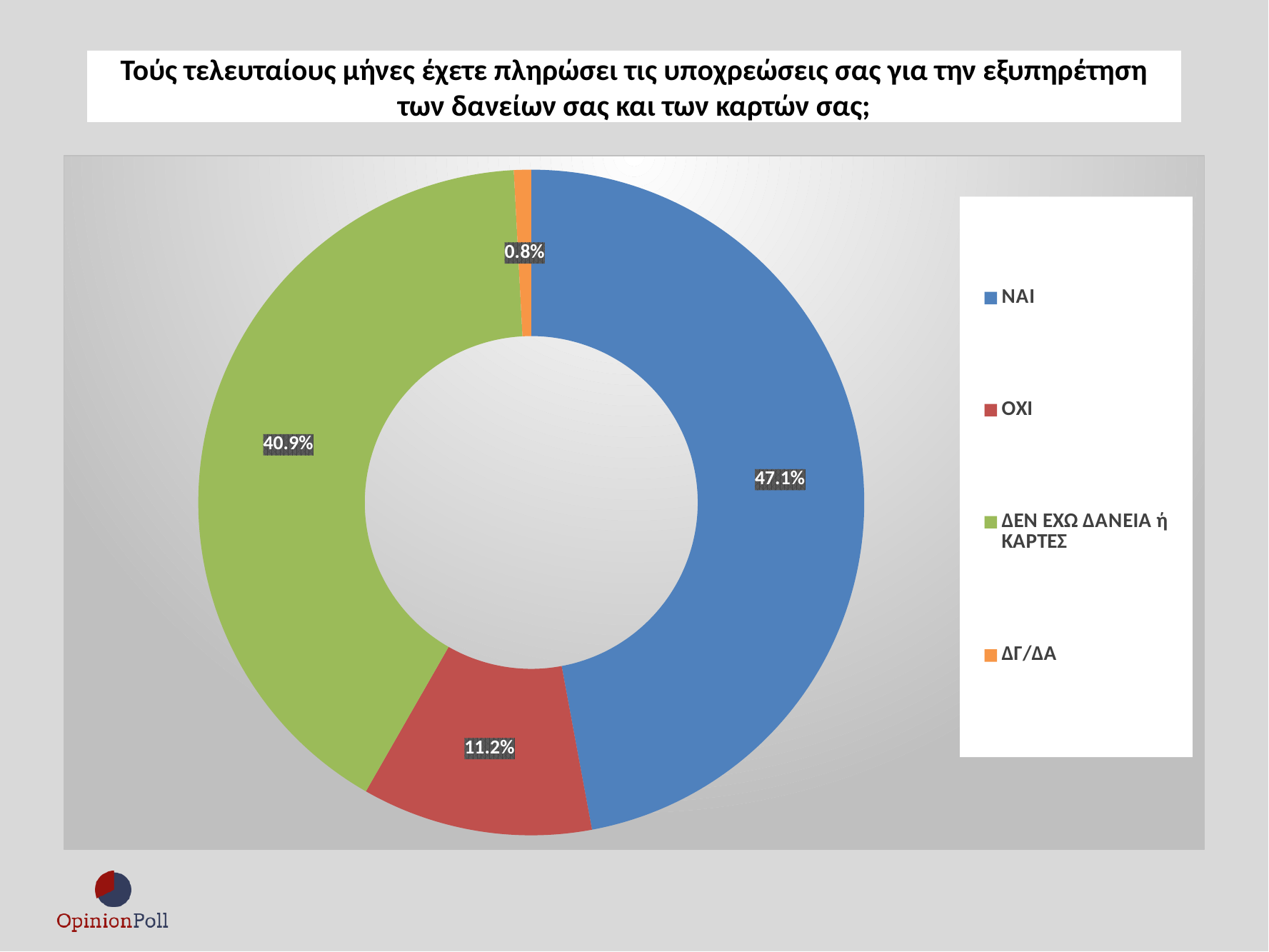
Which is larger, the share for ΟΧΙ or the share for ΔΕΝ ΕΧΩ ΔΑΝΕΙΑ ή ΚΑΡΤΕΣ? ΔΕΝ ΕΧΩ ΔΑΝΕΙΑ ή ΚΑΡΤΕΣ Which response has the largest share of the chart? ΝΑΙ What percentage of respondents answered ΟΧΙ? 11.2% Which response has the smallest share of the chart? ΔΓ/ΔΑ What percentage of respondents answered ΝΑΙ? 47.1% What percentage of respondents answered ΔΓ/ΔΑ? 0.8% What kind of chart is shown on the slide? Pie chart (doughnut) What colour represents ΟΧΙ in the chart? Red What is the difference in percentage points between ΝΑΙ and ΔΕΝ ΕΧΩ ΔΑΝΕΙΑ ή ΚΑΡΤΕΣ? 6.2 What percentage of respondents answered ΔΕΝ ΕΧΩ ΔΑΝΕΙΑ ή ΚΑΡΤΕΣ? 40.9% How many categories does the chart show? 4 What is the difference in percentage points between ΝΑΙ and ΟΧΙ? 35.9